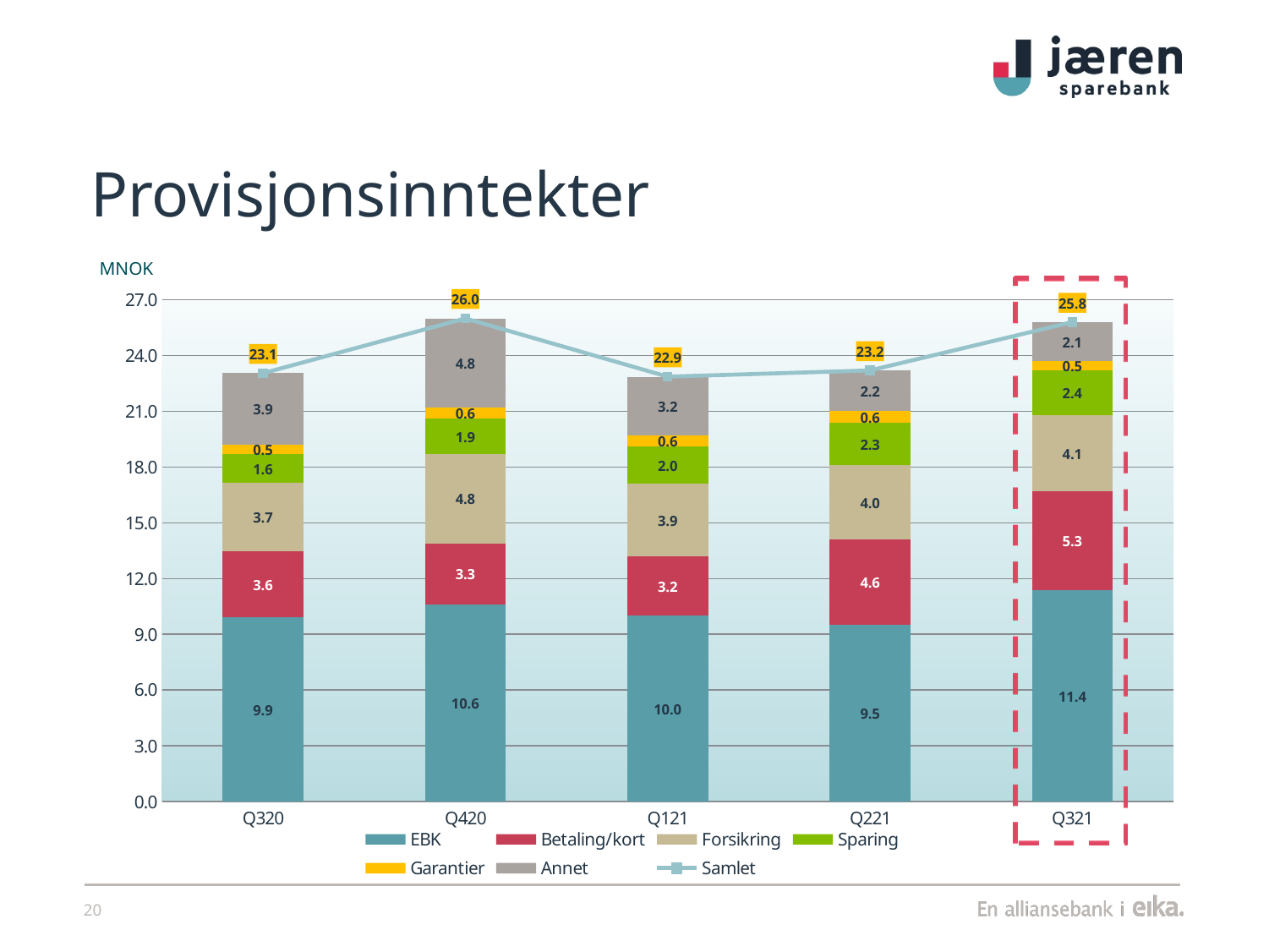
What is the Samlet (total) value for Q420? 26.0 What is the EBK value for Q321? 11.4 What is the total of the stacked bar for Q320? 23.1 What is the difference between the Samlet values for Q321 and Q221? 2.6 Which quarter has the lowest Samlet value? Q121 How many quarters are shown on the x axis? 5 Which quarter has the highest Samlet value? Q420 What unit is shown above the y axis? MNOK Which is larger, the Forsikring value for Q420 or for Q321? Q420 What is the Betaling/kort value for Q221? 4.6 How many series does the legend list? 7 What kind of chart is shown on the slide? Stacked bar chart with a line